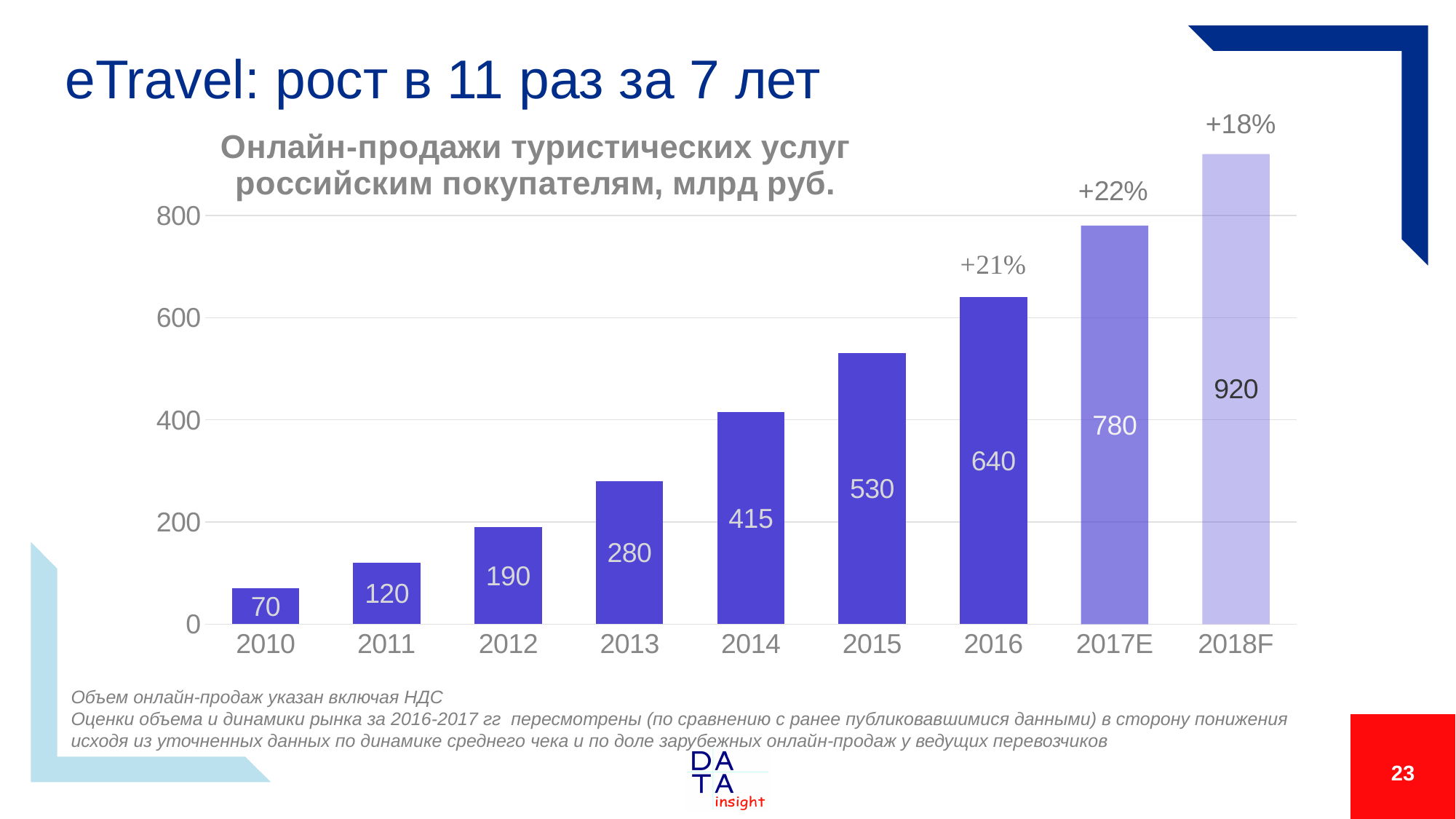
What is the difference between the values for 2017E and 2016? 140 Which is larger, the value for 2013 or the value for 2012? 2013 How many years are shown on the x axis? 9 What is the title of the chart? Онлайн-продажи туристических услуг российским покупателям, млрд руб. Which year has the lowest value? 2010 What is the value for 2018F? 920 What growth percentage is shown above the 2017E bar? +22% What kind of chart is this? bar chart Which year has the highest value? 2018F Do the values rise or fall from 2010 to 2018F? rise What is the value for 2010? 70 What is the value for 2014? 415